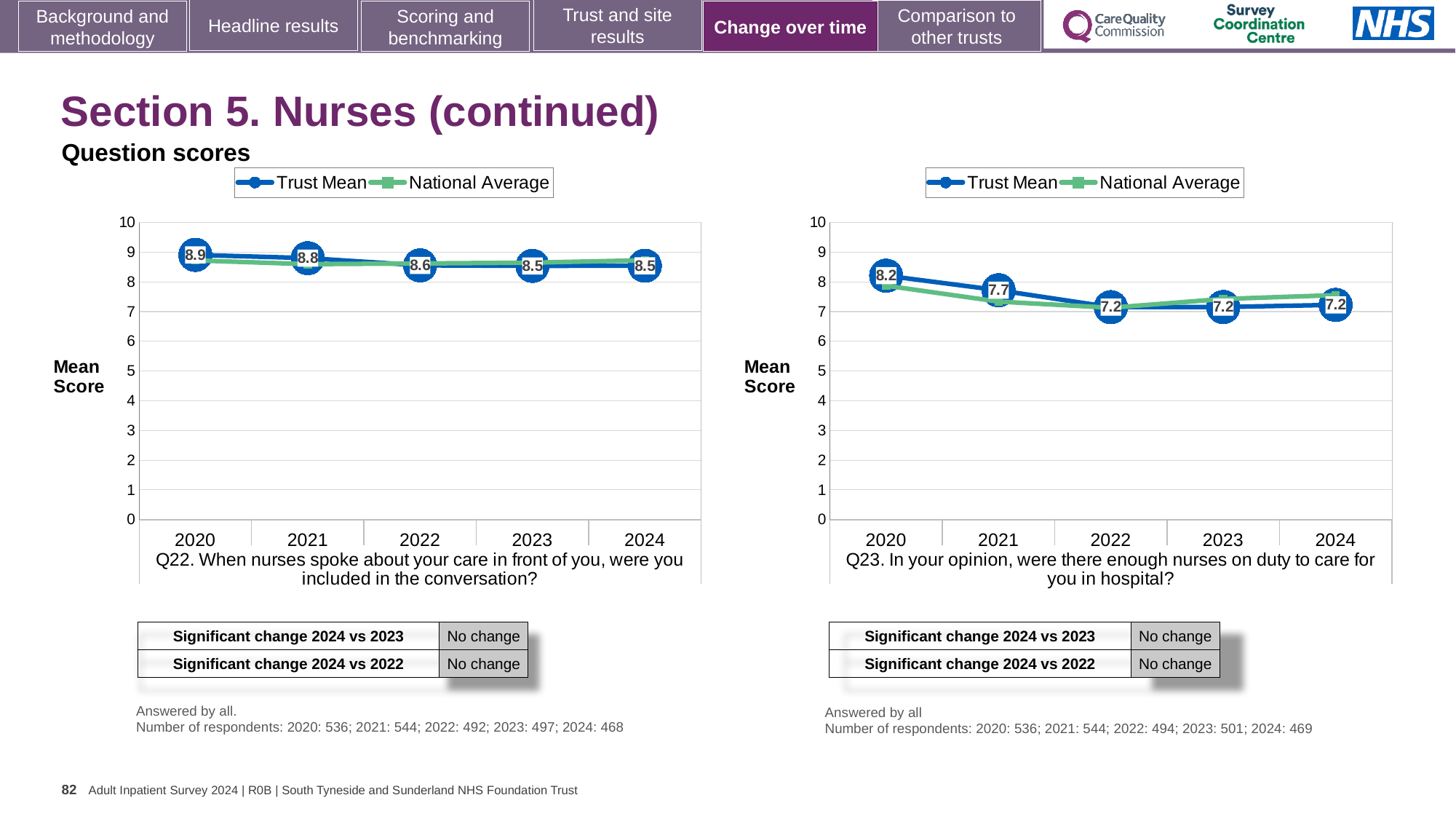
How many years are shown on the x axis of the Q22 chart (left)? 5 In the Q23 chart (right), which year has the highest Trust Mean score? 2020 In the Q22 chart (left), is the Trust Mean score for 2021 larger than the Trust Mean score for 2023? Yes In the Q23 chart (right), what is the difference between the Trust Mean scores for 2020 and 2021? 0.5 In the Q22 chart (left), which year has the highest Trust Mean score? 2020 In the Q22 chart (left), what is the difference between the Trust Mean scores for 2020 and 2024? 0.4 In the Q23 chart (right), what is the Trust Mean score for 2021? 7.7 In the Q23 chart (right), is the National Average value for 2020 greater or less than 7? greater How many series does the legend of the Q23 chart (right) list? 2 In the Q23 chart (right), what is the Trust Mean score for 2024? 7.2 In the Q22 chart (left), what is the Trust Mean score for 2020? 8.9 In the Q22 chart (left), what is the Trust Mean score for 2022? 8.6